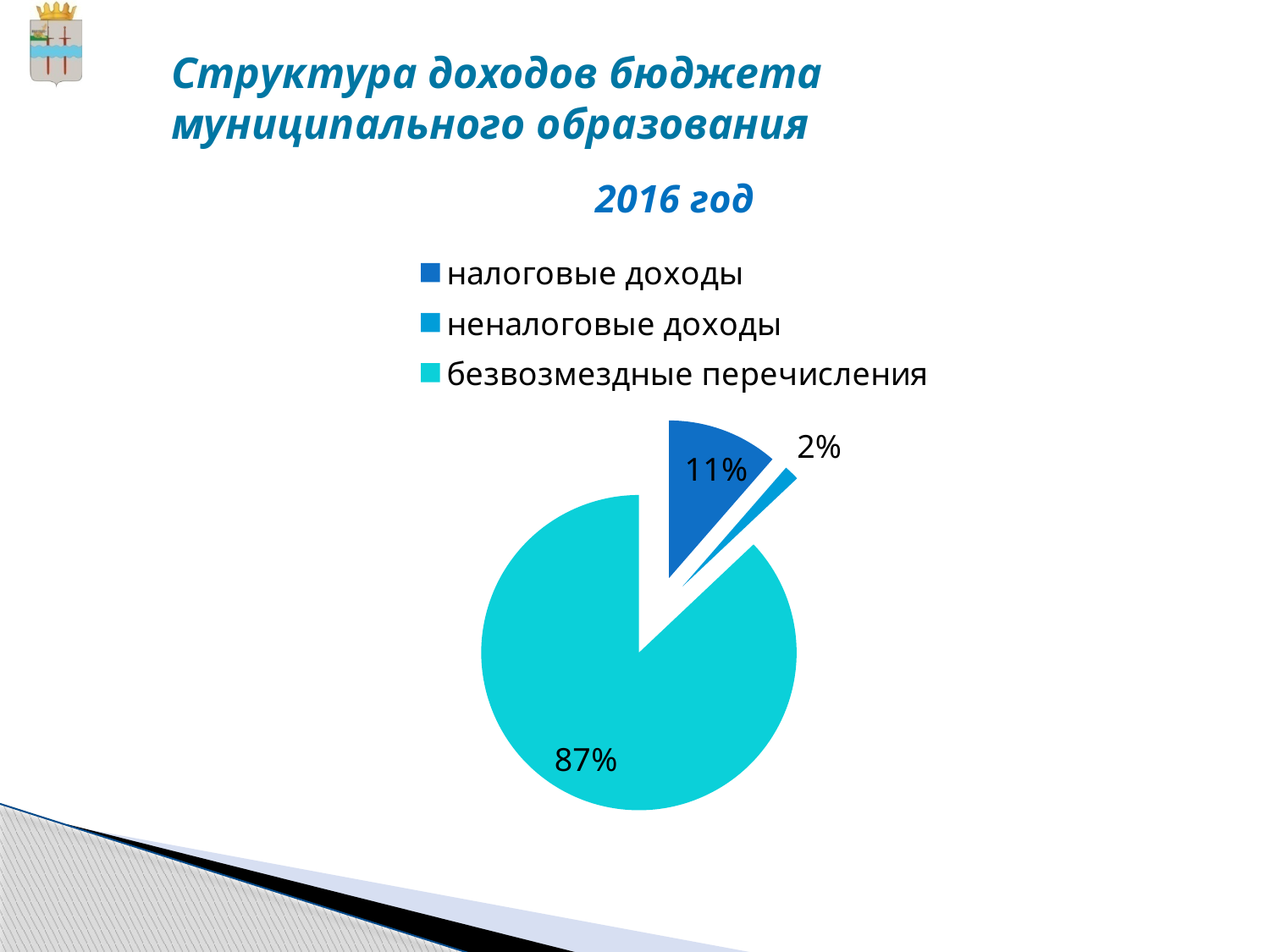
What year does the chart title refer to? 2016 год Which is larger, налоговые доходы or неналоговые доходы? налоговые доходы What share of the pie does неналоговые доходы take? 2% What kind of chart is shown on the slide? pie chart How many categories does the pie chart show? 3 Which legend entry is shown in dark blue? налоговые доходы What share of the pie does налоговые доходы take? 11% Which category has the largest slice of the pie? безвозмездные перечисления What is the difference in percentage points between налоговые доходы and неналоговые доходы? 9 Which category has the smallest slice of the pie? неналоговые доходы What share of the pie does безвозмездные перечисления take? 87% What is the difference in percentage points between безвозмездные перечисления and налоговые доходы? 76